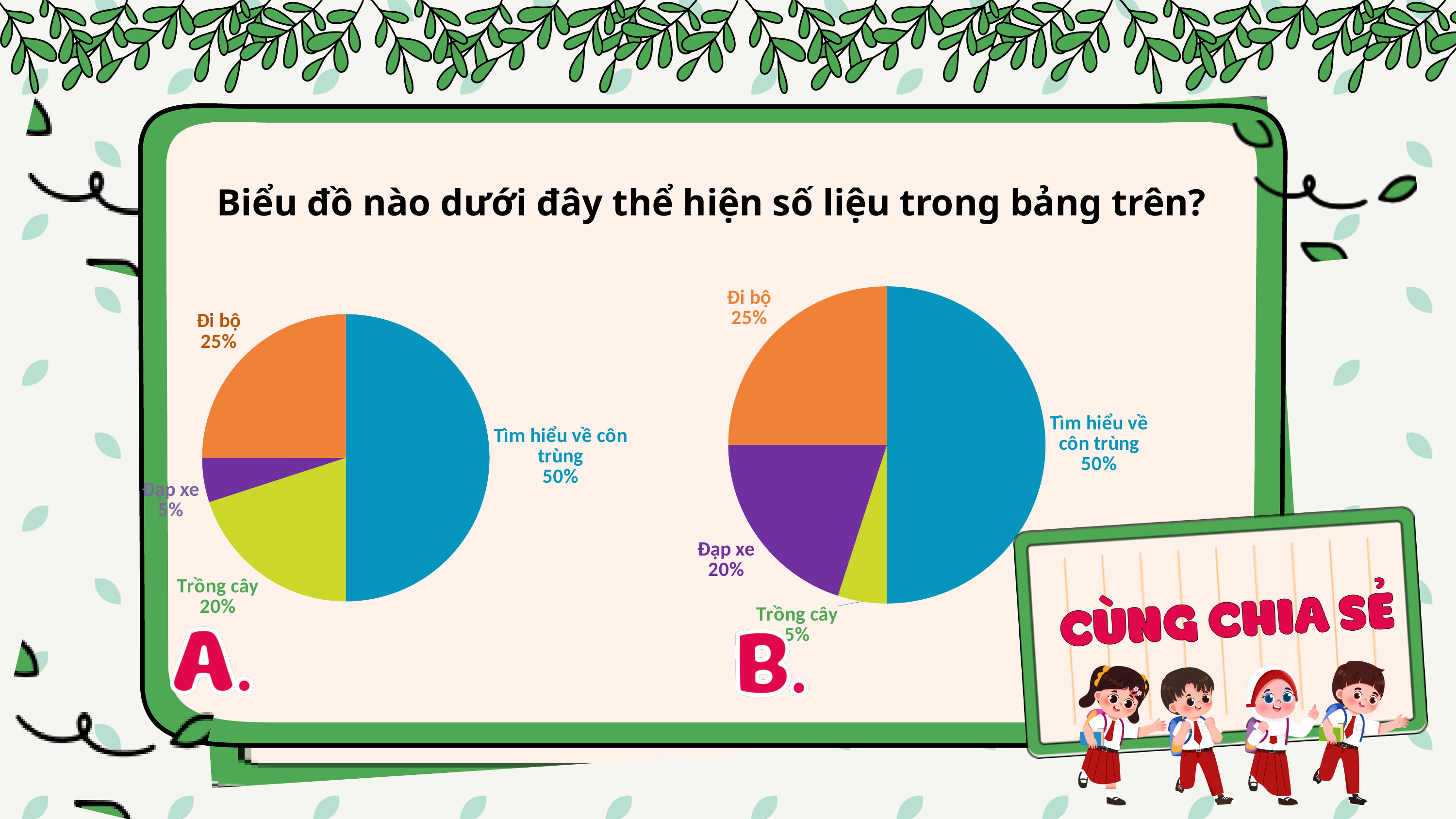
In chart B (right), what percentage is shown for Đạp xe? 20% In chart B (right), what percentage is shown for Trồng cây? 5% In chart A (left), what percentage is shown for Trồng cây? 20% In chart A (left), what percentage is shown for Đạp xe? 5% In chart B (right), what is the difference between the Đi bộ and Đạp xe percentages? 5% In chart B (right), what colour is the Đạp xe slice? Purple How many categories does chart B (right) show? 4 In chart A (left), which category has the smallest slice? Đạp xe In chart A (left), which is larger, Đi bộ or Trồng cây? Đi bộ What type of chart is chart A (left)? Pie chart In chart A (left), which category has the largest slice? Tìm hiểu về côn trùng In chart B (right), which category has the smallest slice? Trồng cây